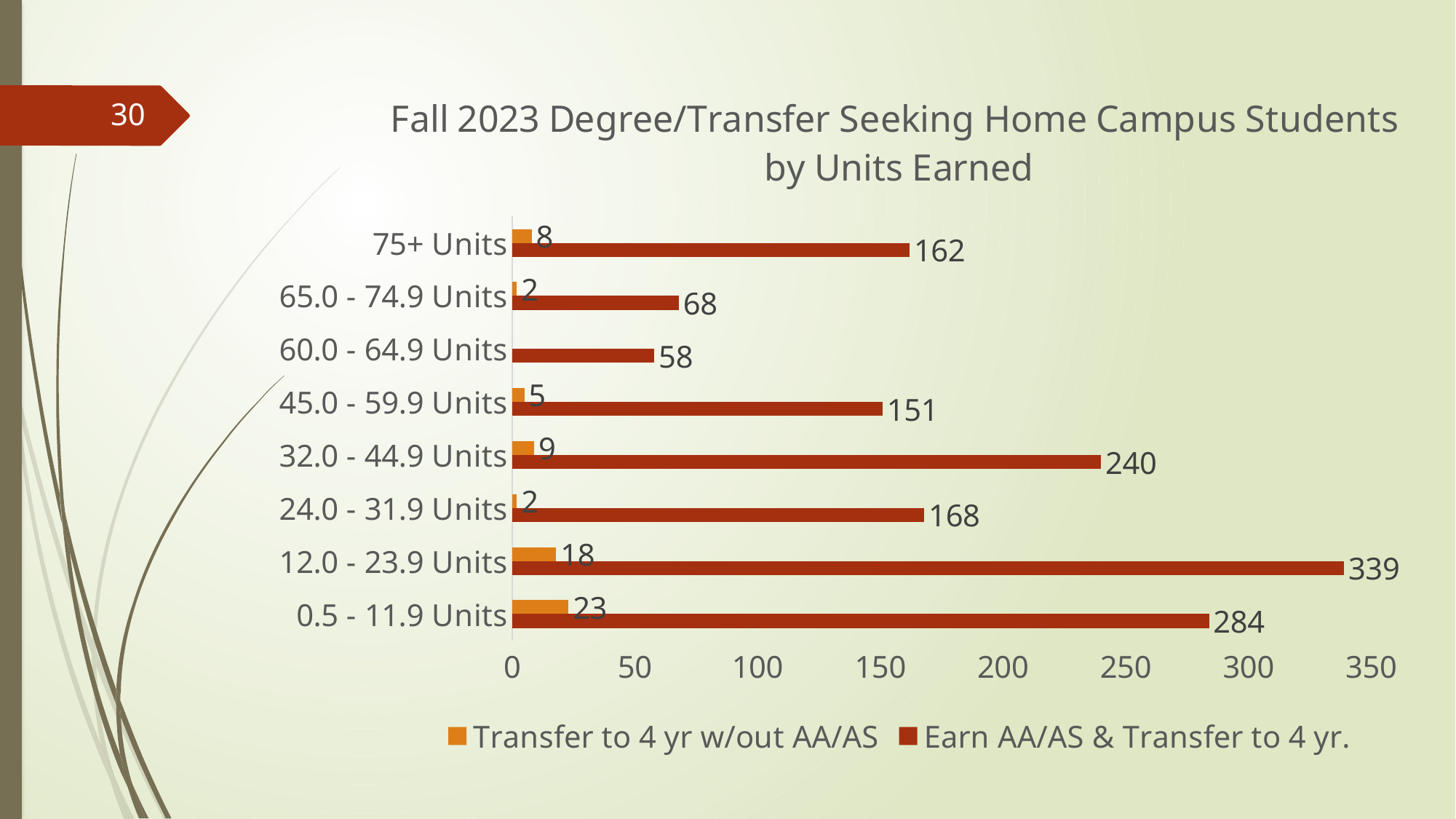
What is the value for 'Earn AA/AS & Transfer to 4 yr.' in the 32.0 - 44.9 Units category? 240 Which category has the lowest value for 'Earn AA/AS & Transfer to 4 yr.'? 60.0 - 64.9 Units What is the value for 'Earn AA/AS & Transfer to 4 yr.' in the 12.0 - 23.9 Units category? 339 What is the title of the chart? Fall 2023 Degree/Transfer Seeking Home Campus Students by Units Earned Which category has the highest value for 'Earn AA/AS & Transfer to 4 yr.'? 12.0 - 23.9 Units What is the value for 'Transfer to 4 yr w/out AA/AS' in the 0.5 - 11.9 Units category? 23 How many series does the legend list? 2 Is the 'Earn AA/AS & Transfer to 4 yr.' value for 45.0 - 59.9 Units greater or less than 200? less How many unit-range categories are shown on the chart? 8 What kind of chart is shown on the slide? bar chart Which is larger for 'Earn AA/AS & Transfer to 4 yr.': 75+ Units or 24.0 - 31.9 Units? 24.0 - 31.9 Units What is the difference between the 'Earn AA/AS & Transfer to 4 yr.' values for 12.0 - 23.9 Units and 0.5 - 11.9 Units? 55